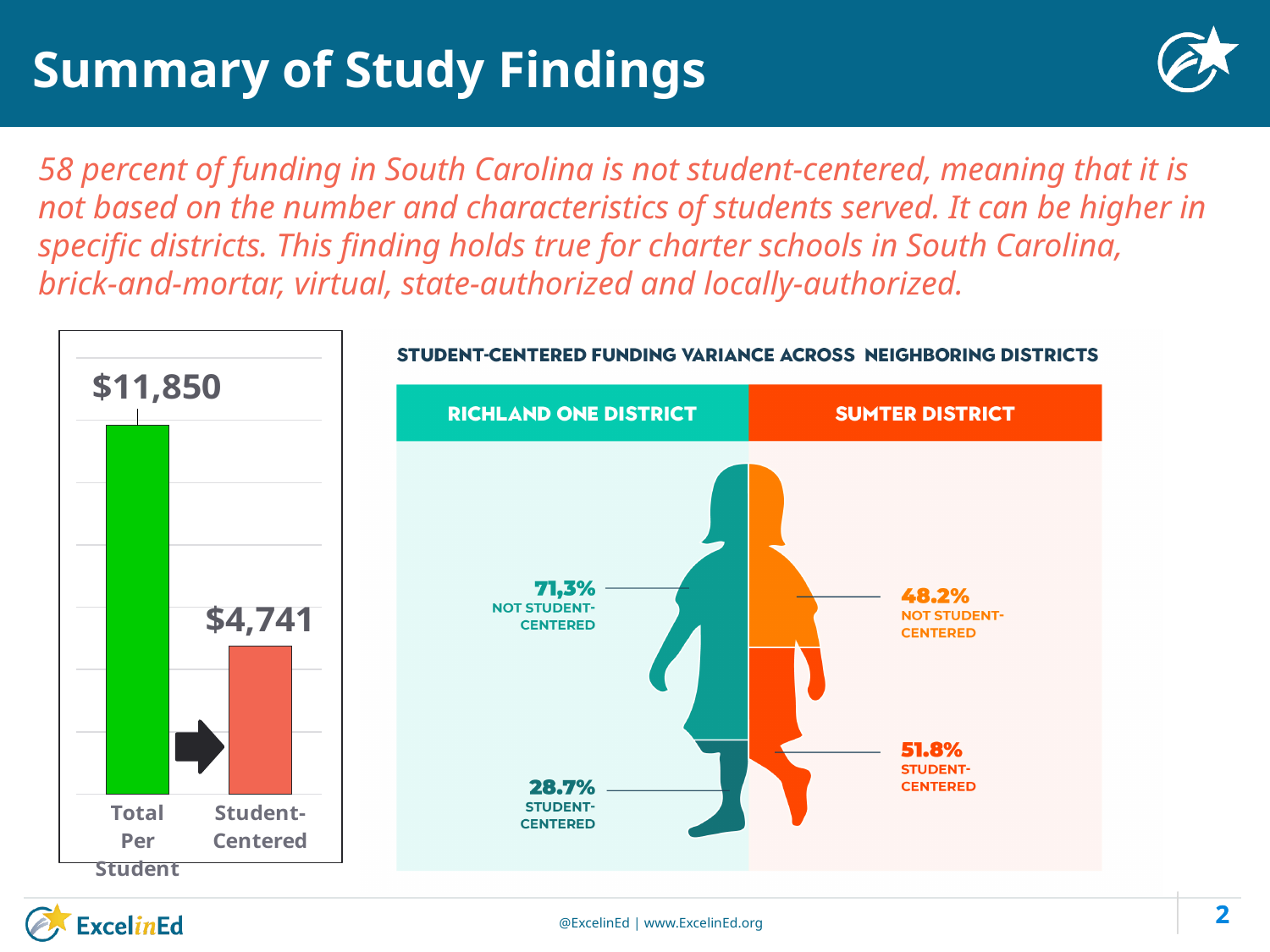
In the bar chart on the left, what colour is the Total Per Student bar? Green In the bar chart on the left, which category has the lowest value? Student-Centered In the bar chart on the left, which category has the highest value? Total Per Student In the graphic on the right titled 'Student-Centered Funding Variance Across Neighboring Districts', what percentage of funding in Sumter District is student-centered? 51.8% In the graphic on the right titled 'Student-Centered Funding Variance Across Neighboring Districts', what percentage of funding in Richland One District is not student-centered? 71,3% In the bar chart on the left, what is the value for Student-Centered? $4,741 In the bar chart on the left, which is larger: Total Per Student or Student-Centered? Total Per Student In the graphic on the right, which district has the larger share of student-centered funding: Richland One District or Sumter District? Sumter District In the bar chart on the left, what is the value for Total Per Student? $11,850 In the bar chart on the left, what is the difference between Total Per Student and Student-Centered? $7,109 How many bars are shown in the bar chart on the left? 2 What kind of chart is shown on the left of the slide? Bar chart